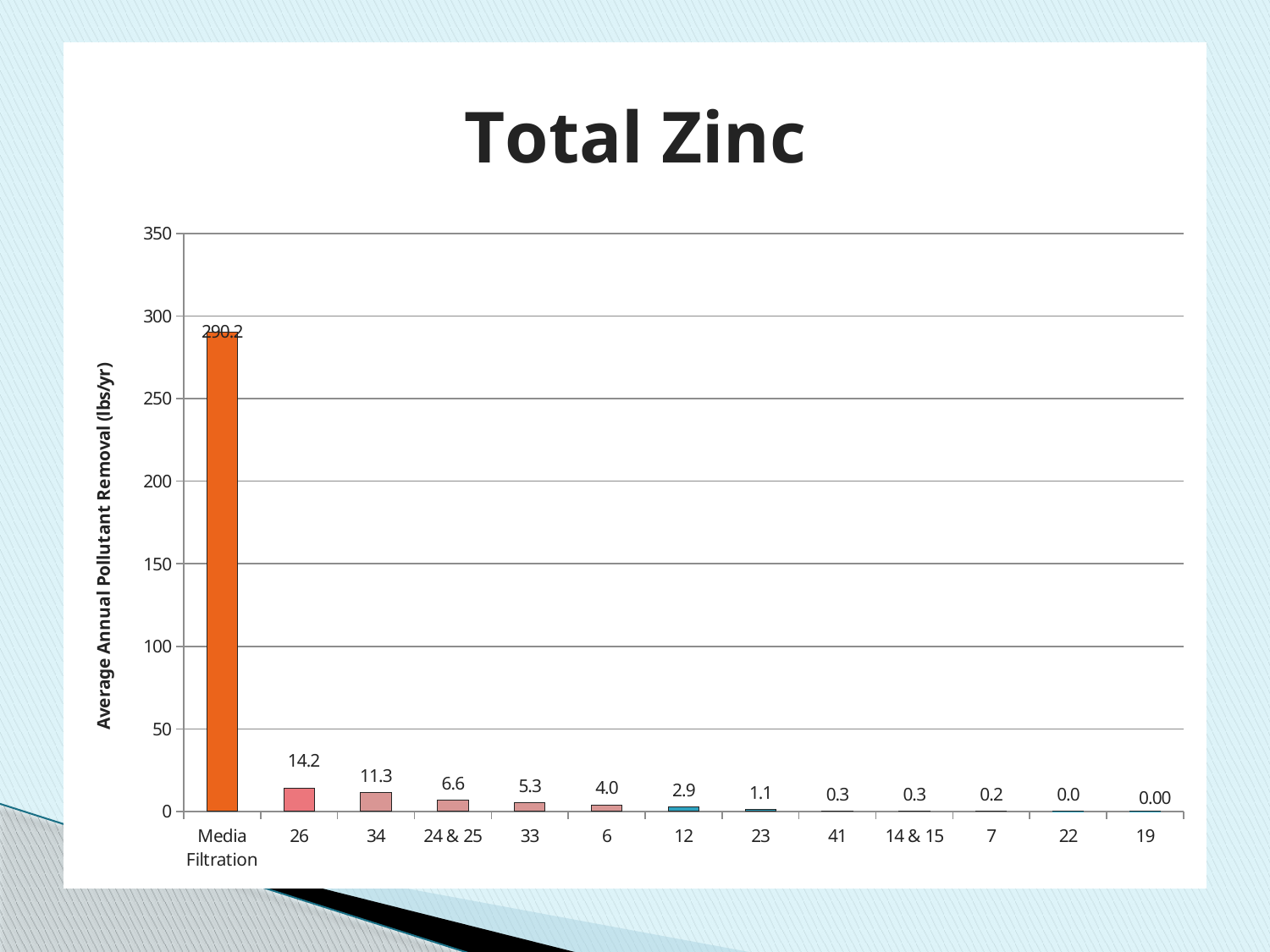
Which is larger, the value for category 33 or the value for category 6? 33 What is the value for Media Filtration? 290.2 What kind of chart is this? bar chart What is the value for category 26? 14.2 What is the value for category 12? 2.9 Do the values rise or fall from left to right along the x axis? fall Is the value for Media Filtration greater or less than 250? greater What is the value for category 24 & 25? 6.6 How many categories are shown on the x axis? 13 What is the title of the chart? Total Zinc What is the difference between the values for category 26 and category 34? 2.9 Which category has the highest value? Media Filtration